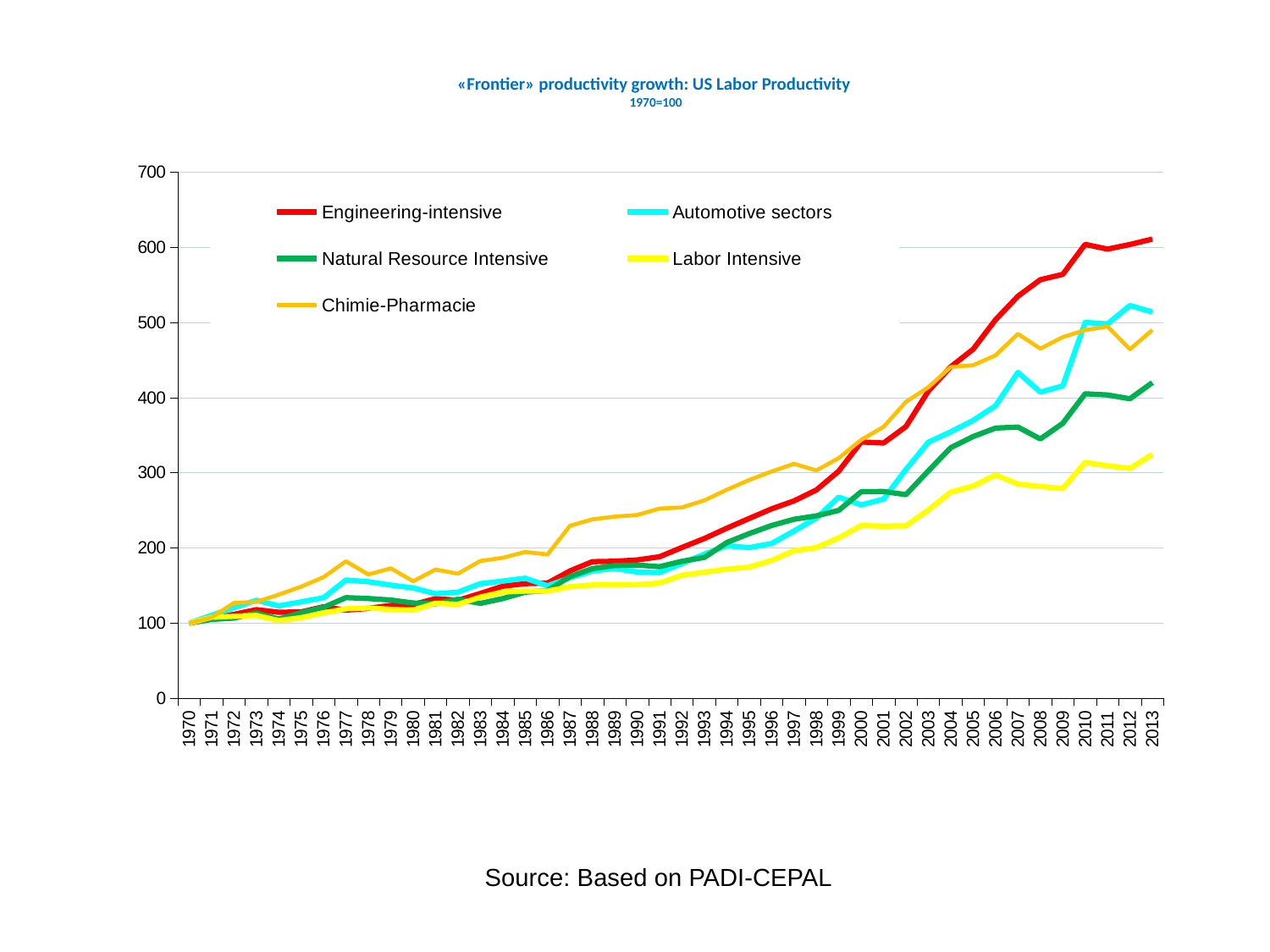
How many years are plotted along the x axis? 44 Which series has the highest value in 1990? Chimie-Pharmacie What kind of chart is shown on the slide? line chart Which series has the highest value in 2013? Engineering-intensive How many series does the legend list? 5 In 1990, which is larger: Chimie-Pharmacie or Engineering-intensive? Chimie-Pharmacie Is the value for Engineering-intensive in 2013 greater or less than 500? greater Which series has the lowest value in 2013? Labor Intensive Does the Engineering-intensive series generally rise or fall from 1970 to 2013? rise What is the value of every series in 1970? 100 Is the value for Labor Intensive in 2013 greater or less than 300? greater